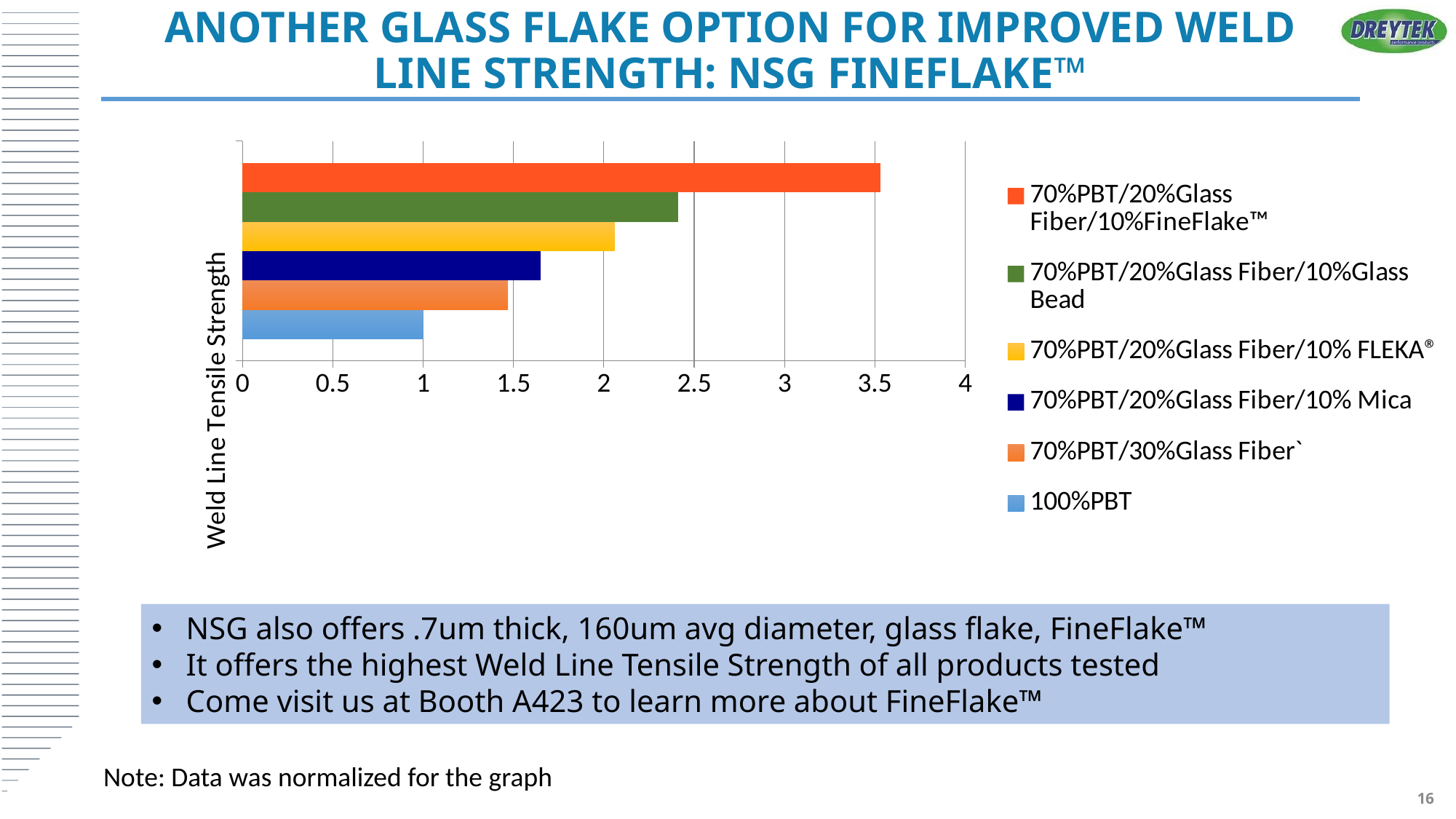
Which has a higher Weld Line Tensile Strength: 70%PBT/20%Glass Fiber/10% Mica or 70%PBT/30%Glass Fiber? 70%PBT/20%Glass Fiber/10% Mica Is the value for 70%PBT/20%Glass Fiber/10% Mica greater or less than 1.5? greater Which has a higher Weld Line Tensile Strength: 70%PBT/20%Glass Fiber/10%Glass Bead or 70%PBT/20%Glass Fiber/10% FLEKA®? 70%PBT/20%Glass Fiber/10%Glass Bead Is the value for 70%PBT/30%Glass Fiber greater or less than 2? less What type of chart is shown on the slide? Bar chart Is the value for 70%PBT/20%Glass Fiber/10%Glass Bead greater or less than 2.5? less Which series has the lowest Weld Line Tensile Strength? 100%PBT Which series has the highest Weld Line Tensile Strength? 70%PBT/20%Glass Fiber/10%FineFlake™ How many series does the chart legend list? 6 What is the normalized Weld Line Tensile Strength value for 100%PBT? 1 What is the label on the vertical axis of the chart? Weld Line Tensile Strength